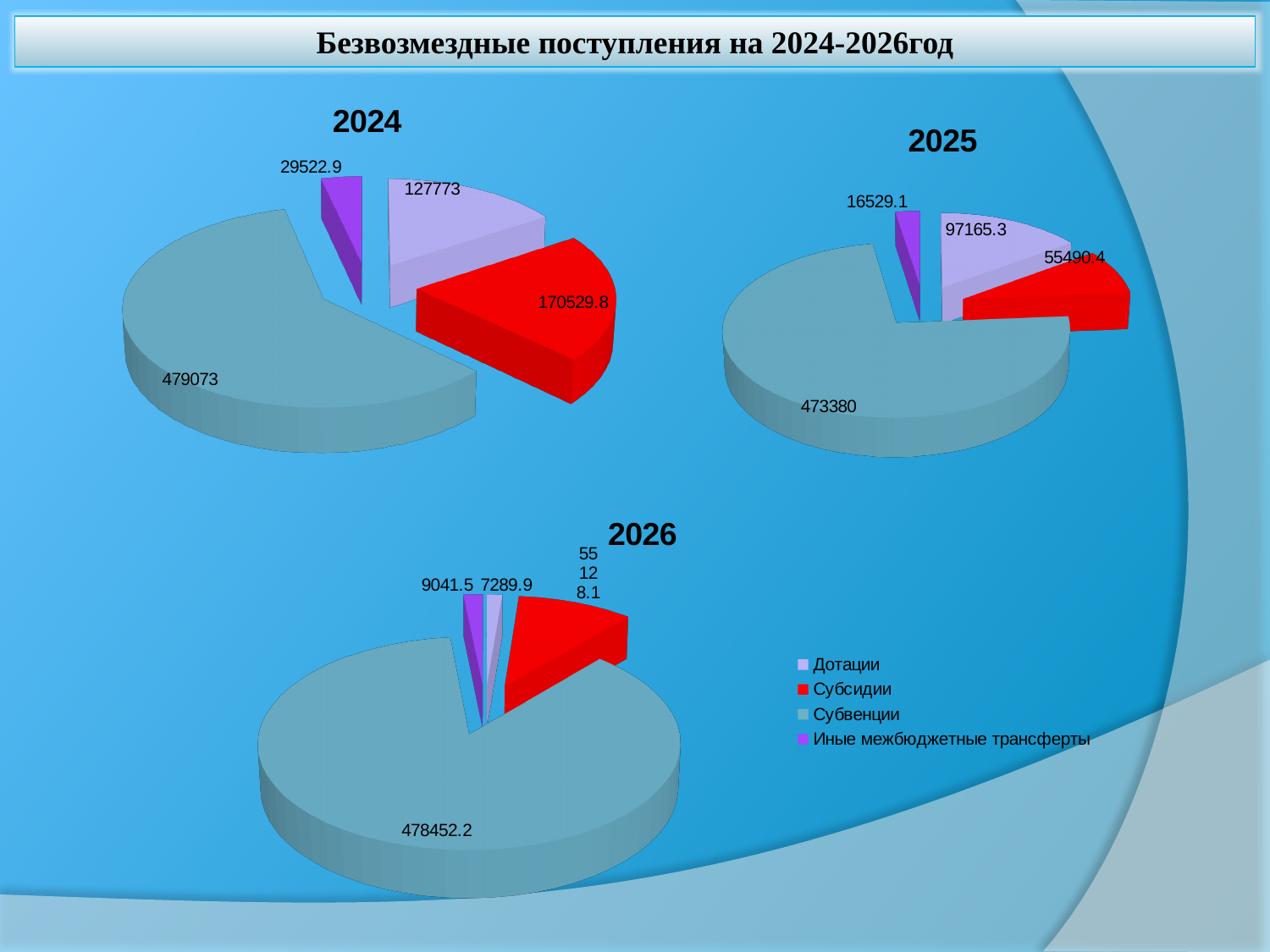
In the 2024 pie chart, which category has the smallest slice? Иные межбюджетные трансферты In the 2025 pie chart, which is larger, Дотации or Субсидии? Дотации In the 2025 pie chart, what is the value for Дотации? 97165.3 In the 2024 pie chart, what is the difference between Субсидии and Дотации? 42756.8 In the 2026 pie chart, what is the value for Иные межбюджетные трансферты? 9041.5 In the 2024 pie chart, what is the value for Субвенции? 479073 In the 2025 pie chart, what is the difference between Дотации and Субсидии? 41674.9 What type of chart is used for the 2024 data? Pie chart How many entries does the legend list? 4 In the 2025 pie chart, which category has the largest slice? Субвенции In the 2024 pie chart, what is the value for Субсидии? 170529.8 How many slices does the 2026 pie chart have? 4